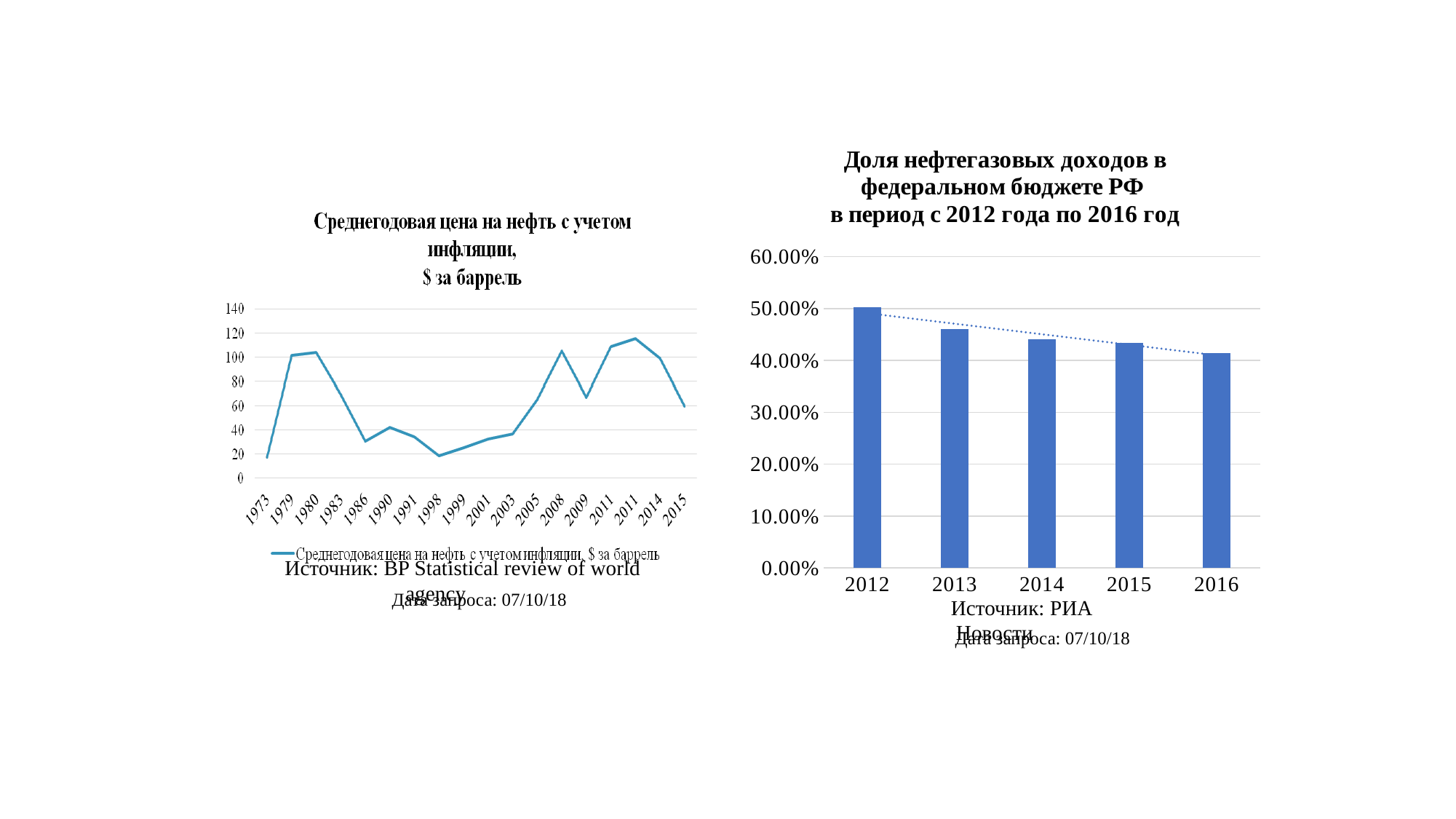
What kind of chart is the left chart, 'Среднегодовая цена на нефть с учетом инфляции, $ за баррель'? line chart In the right chart, how many years (bars) are shown? 5 In the left chart, is the value for 1986 greater or less than 40? less In the left chart, is the value for 1979 greater or less than 80? greater In the right chart, is the value for 2014 greater or less than 40.00%? greater In the right chart, which year has the highest share of oil and gas revenues? 2012 In the right chart, which year has the lowest share of oil and gas revenues? 2016 In the right chart, do the values rise or fall from 2012 to 2016? fall What kind of chart is the right chart, 'Доля нефтегазовых доходов в федеральном бюджете РФ в период с 2012 года по 2016 год'? bar chart In the left chart, which is larger, the value for 1980 or the value for 1986? 1980 In the left chart, what source is cited below the chart? BP Statistical review of world agency